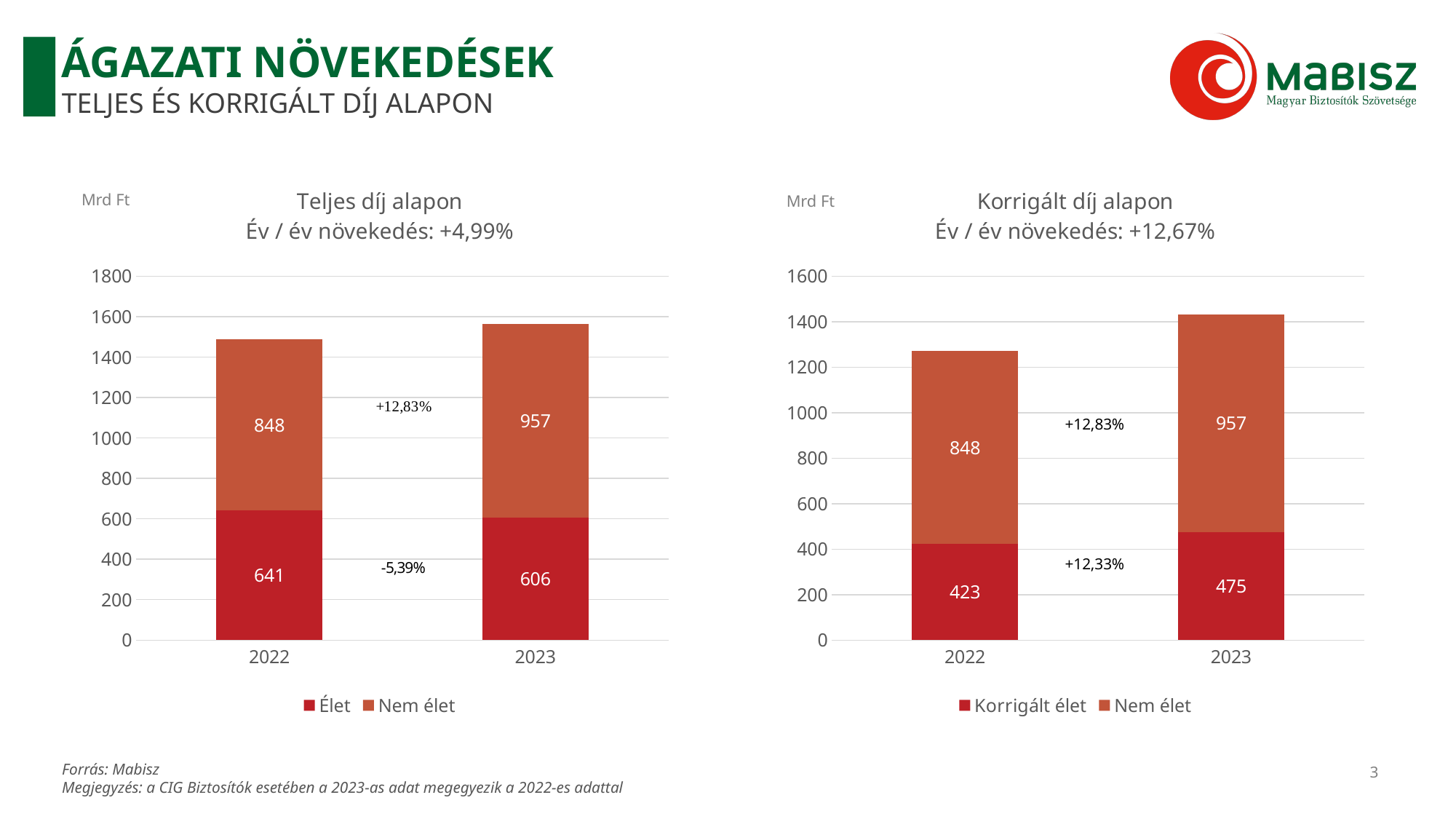
What kind of chart is the 'Teljes díj alapon' chart? stacked bar chart In the 'Korrigált díj alapon' chart, what is the total of the stacked bar for 2023? 1432 In the 'Korrigált díj alapon' chart, which year has the larger Korrigált élet value, 2022 or 2023? 2023 In the 'Korrigált díj alapon' chart, what is the value of Korrigált élet for 2023? 475 What year-over-year growth is stated in the title of the 'Korrigált díj alapon' chart? +12,67% In the 'Teljes díj alapon' chart, what is the difference between the Élet values for 2022 and 2023? 35 How many series does the legend of the 'Korrigált díj alapon' chart list? 2 In the 'Teljes díj alapon' chart, what is the value of Nem élet for 2023? 957 In the 'Korrigált díj alapon' chart, what is the value of Nem élet for 2022? 848 In the 'Teljes díj alapon' chart, does the Élet value rise or fall from 2022 to 2023? fall In the 'Teljes díj alapon' chart, what is the total of the stacked bar for 2022? 1489 In the 'Teljes díj alapon' chart, what is the value of Élet for 2022? 641